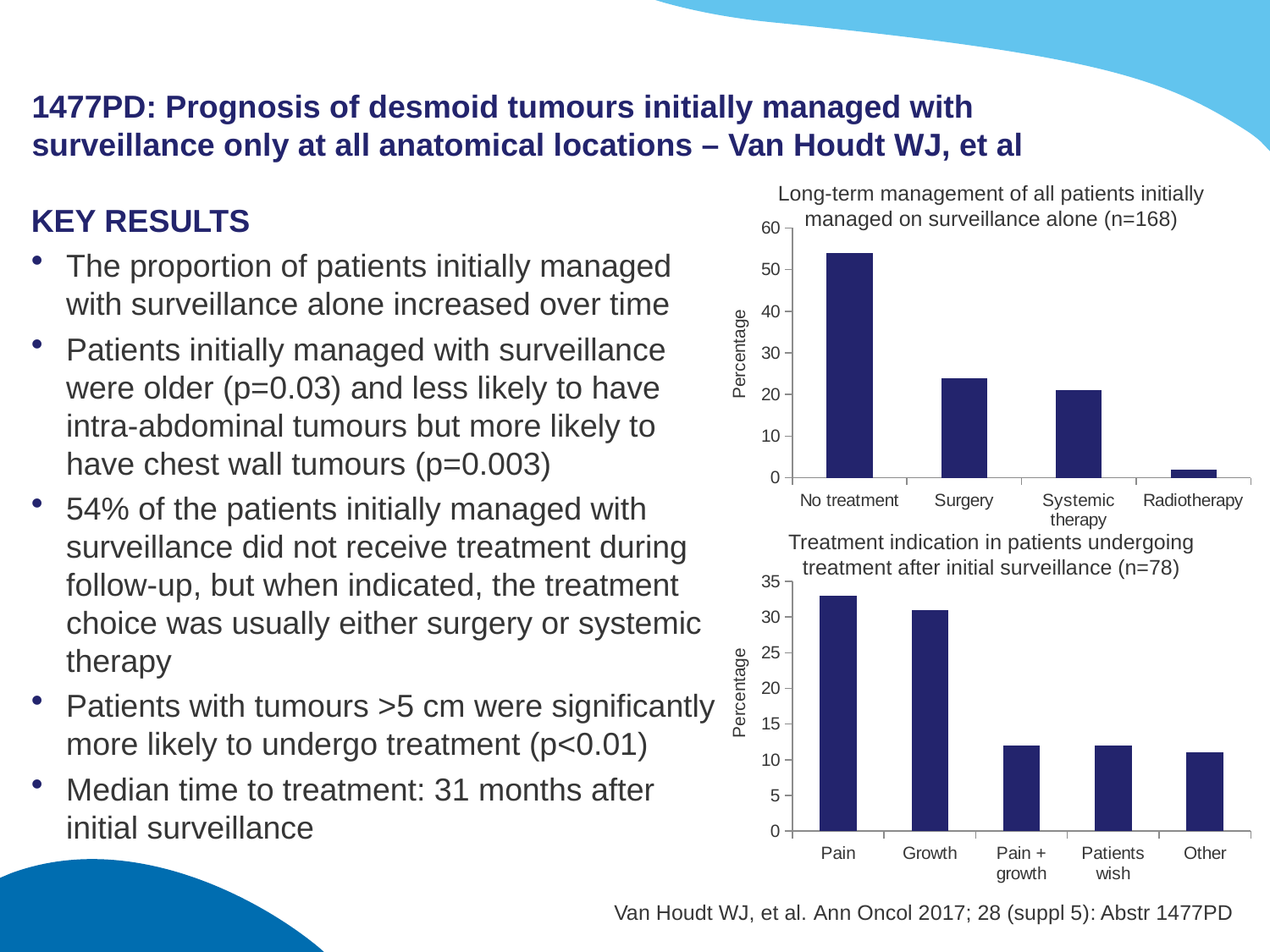
In the top chart (Long-term management), is the value for No treatment greater or less than 50? greater How many categories are shown in the top chart (Long-term management of all patients initially managed on surveillance alone)? 4 What type of chart is the bottom chart (Treatment indication in patients undergoing treatment after initial surveillance)? Bar chart In the top chart (Long-term management), is the value for Surgery greater or less than 20? greater In the top chart (Long-term management of all patients initially managed on surveillance alone), which category has the lowest percentage? Radiotherapy How many categories are shown in the bottom chart (Treatment indication in patients undergoing treatment after initial surveillance)? 5 In the top chart (Long-term management), is the value for Radiotherapy greater or less than 10? less In the bottom chart (Treatment indication in patients undergoing treatment after initial surveillance), which category has the highest percentage? Pain In the top chart (Long-term management), which is larger, the value for Surgery or the value for Systemic therapy? Surgery In the top chart (Long-term management of all patients initially managed on surveillance alone), which category has the highest percentage? No treatment